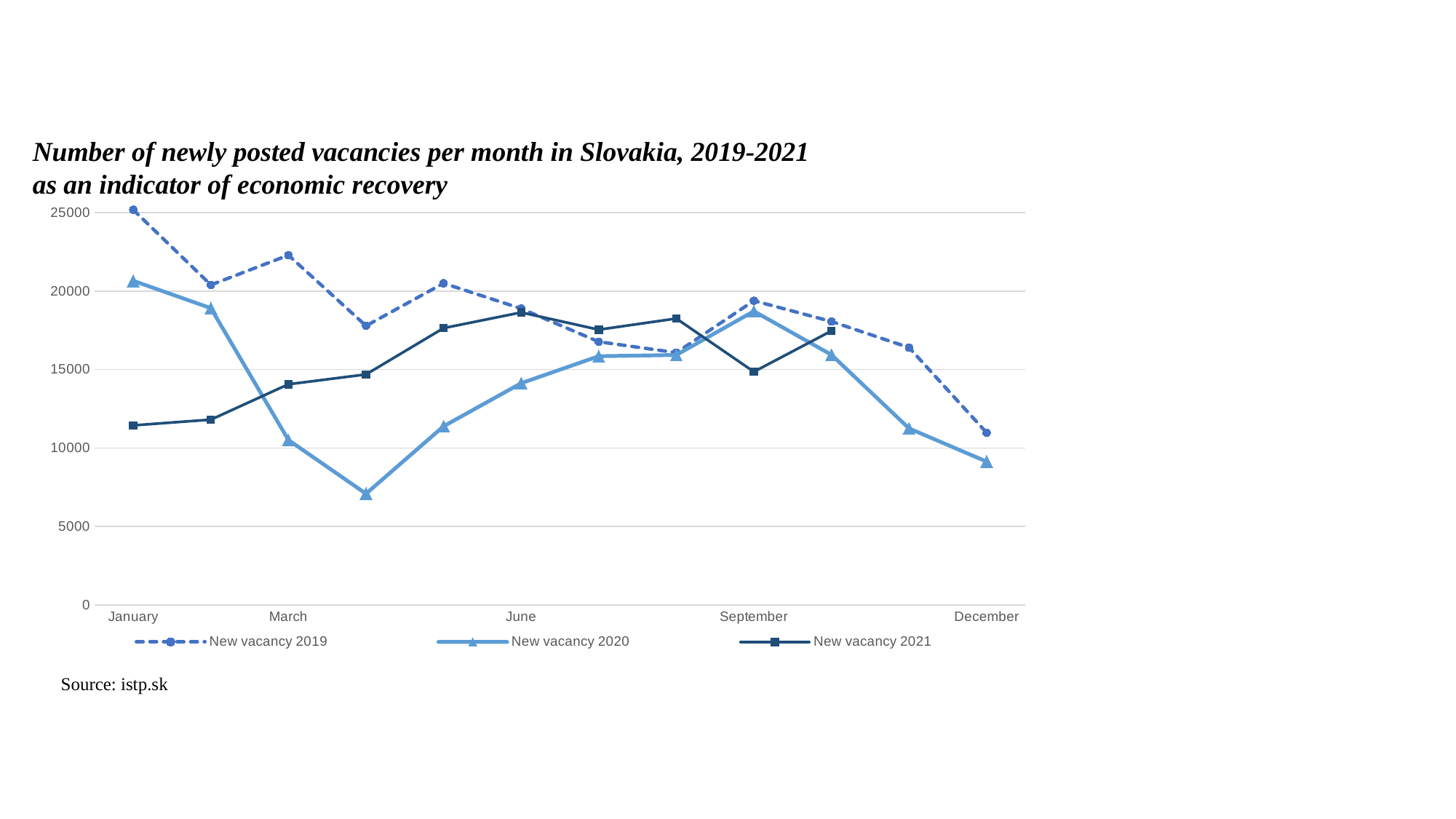
Is the value for New vacancy 2020 in April greater or less than 10000? less What kind of chart is shown on the slide? line chart Is the value for New vacancy 2019 in March greater or less than 20000? greater What source is cited below the chart? istp.sk Which month has the highest value for New vacancy 2019? January In September, which series has the larger value: New vacancy 2020 or New vacancy 2021? New vacancy 2020 Does the New vacancy 2021 series rise or fall from January to June? rise In January, which series has the larger value: New vacancy 2019 or New vacancy 2021? New vacancy 2019 How many data points does the New vacancy 2021 series have? 10 How many series does the legend list? 3 Which month has the lowest value for New vacancy 2020? April Is the value for New vacancy 2021 in January greater or less than 15000? less